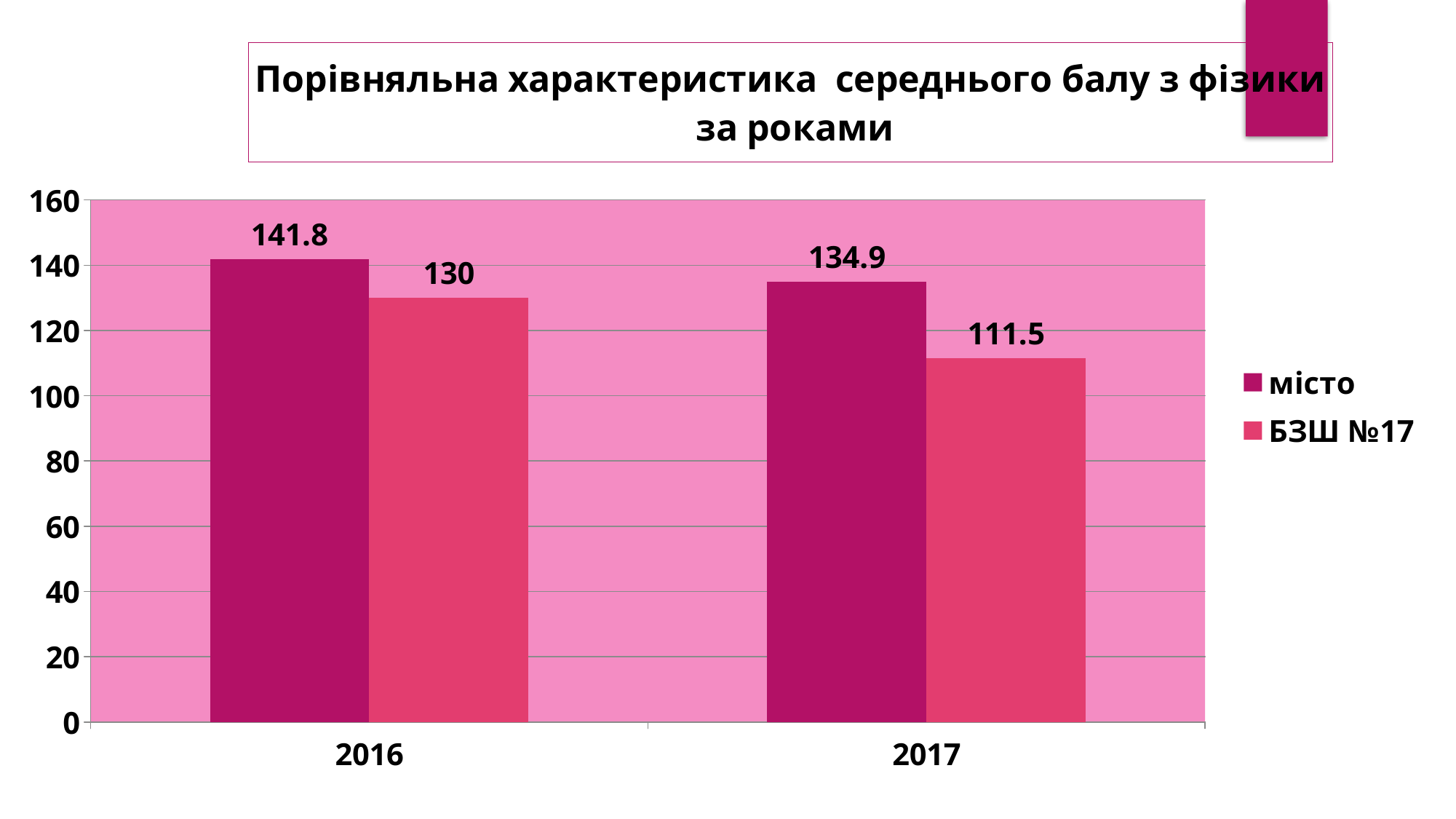
Do the values for БЗШ №17 rise or fall from 2016 to 2017? fall How many series does the legend list? 2 What kind of chart is shown on the slide? bar chart What is the difference between місто and БЗШ №17 in 2017? 23.4 What is the value for місто in 2017? 134.9 What is the value for БЗШ №17 in 2016? 130 What is the difference between the місто values for 2016 and 2017? 6.9 Which is larger in 2016, місто or БЗШ №17? місто What is the value for БЗШ №17 in 2017? 111.5 Which year has the highest value for місто? 2016 What is the value for місто in 2016? 141.8 Which year has the lowest value for БЗШ №17? 2017